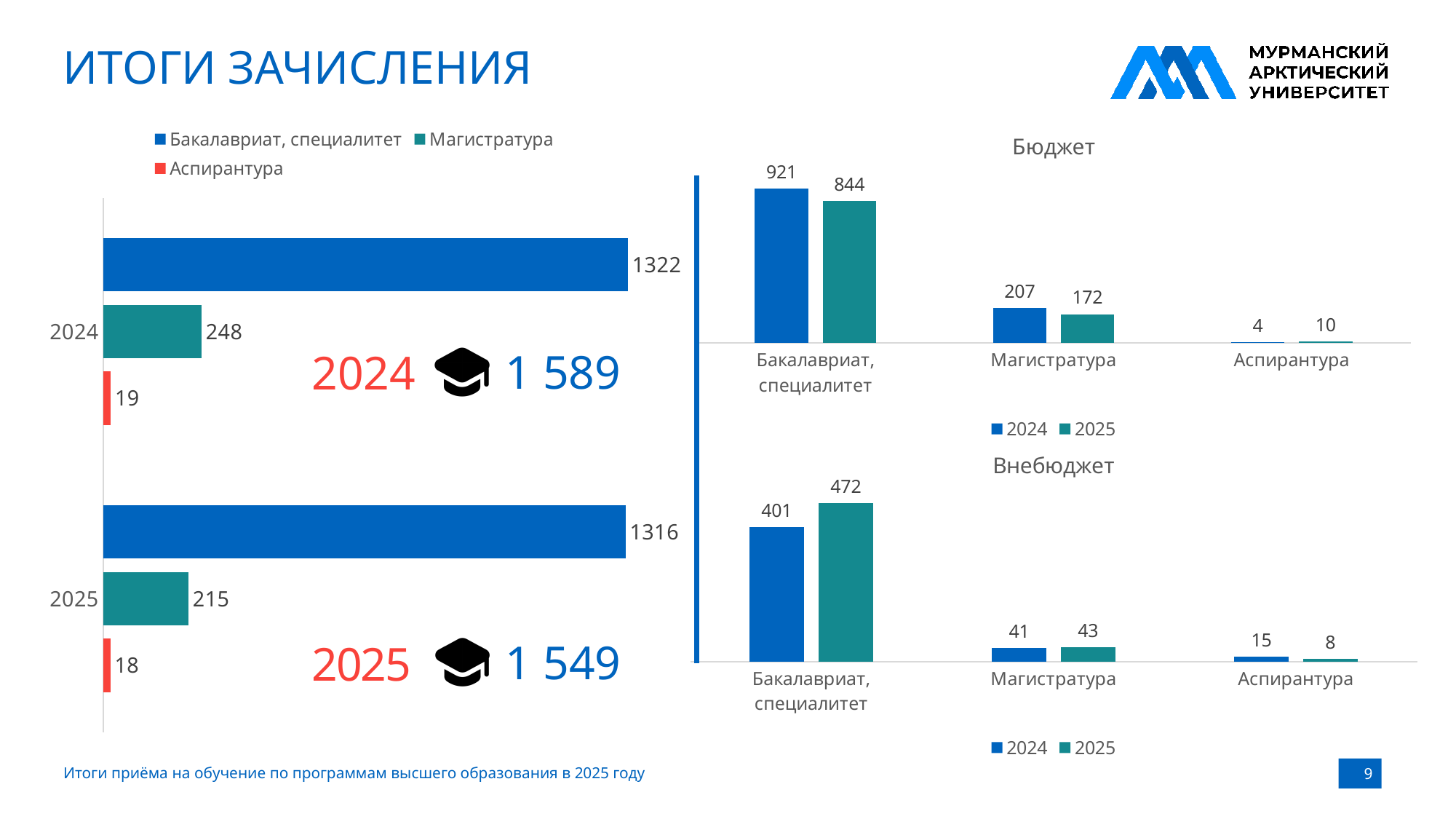
What kind of chart is the left-hand chart? Bar chart In the Бюджет chart, which category has the highest value in 2024? Бакалавриат, специалитет In the Внебюджет chart, how many categories are shown on the x axis? 3 In the left-hand bar chart, what is the value for Бакалавриат, специалитет in 2024? 1322 In the Бюджет chart, what is the value for Магистратура in 2025? 172 In the Внебюджет chart, which is larger for Бакалавриат, специалитет: 2024 or 2025? 2025 In the left-hand bar chart, what is the difference between the Аспирантура values for 2024 and 2025? 1 In the left-hand bar chart, how many series does the legend list? 3 In the Внебюджет chart, which category has the lowest value in 2025? Аспирантура In the Внебюджет chart, what is the value for Аспирантура in 2025? 8 In the Бюджет chart, what is the difference between the 2024 and 2025 values for Бакалавриат, специалитет? 77 In the left-hand bar chart, what is the value for Магистратура in 2025? 215